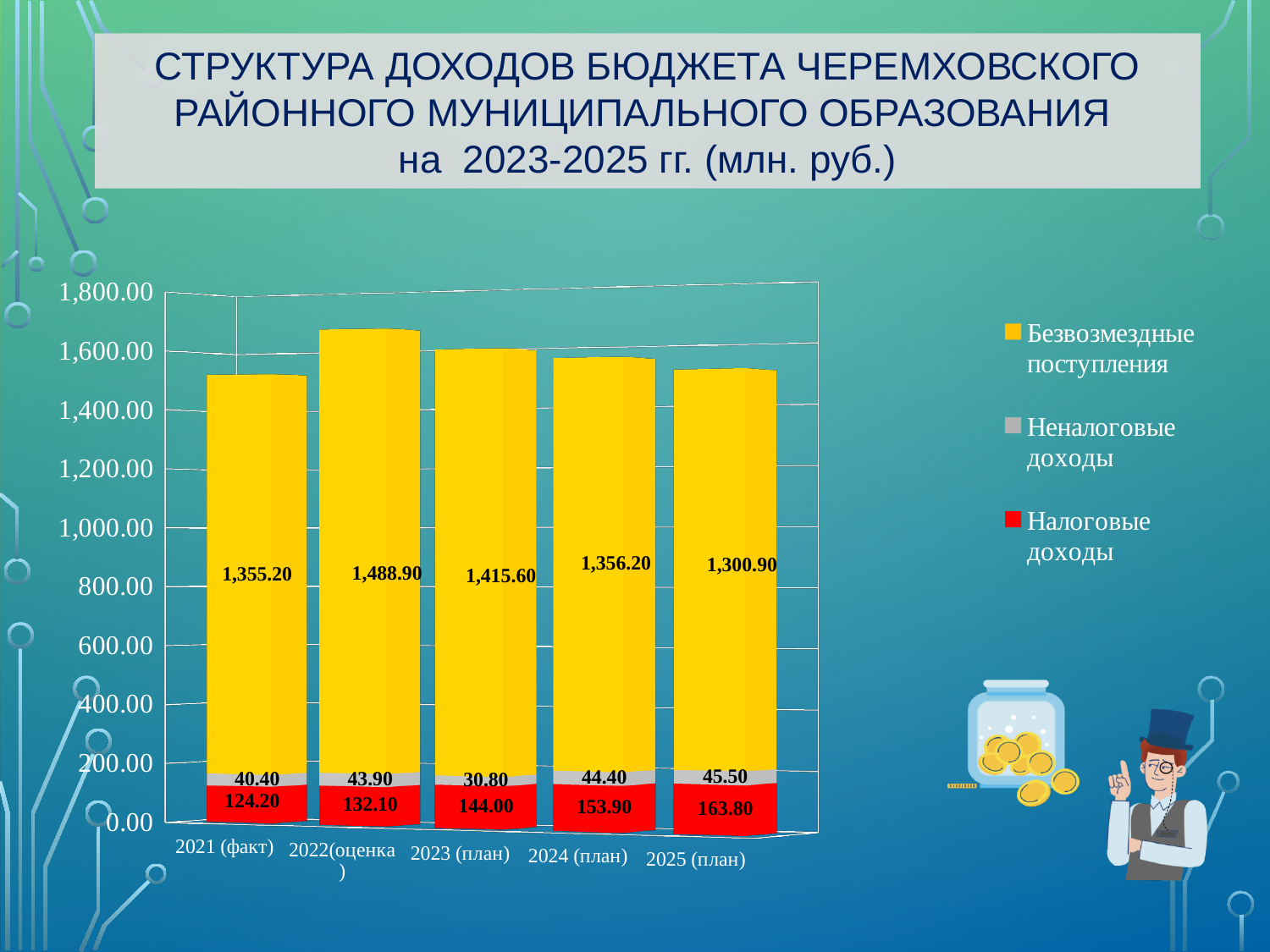
In which year is the value of Безвозмездные поступления the highest? 2022(оценка) What type of chart is shown on the slide? Stacked bar chart In which year is the value of Неналоговые доходы the lowest? 2023 (план) What is the value of Безвозмездные поступления for 2022(оценка)? 1,488.90 How many categories (years) are shown on the x axis? 5 What is the difference between Налоговые доходы in 2025 (план) and 2021 (факт)? 39.60 What is the value of Налоговые доходы for 2025 (план)? 163.80 Do the values of Налоговые доходы rise or fall from 2021 (факт) to 2025 (план)? Rise What is the total of the stacked bar for 2022(оценка)? 1,664.90 What is the value of Неналоговые доходы for 2023 (план)? 30.80 How many series does the legend list? 3 Which is larger: Безвозмездные поступления in 2021 (факт) or in 2024 (план)? 2024 (план)